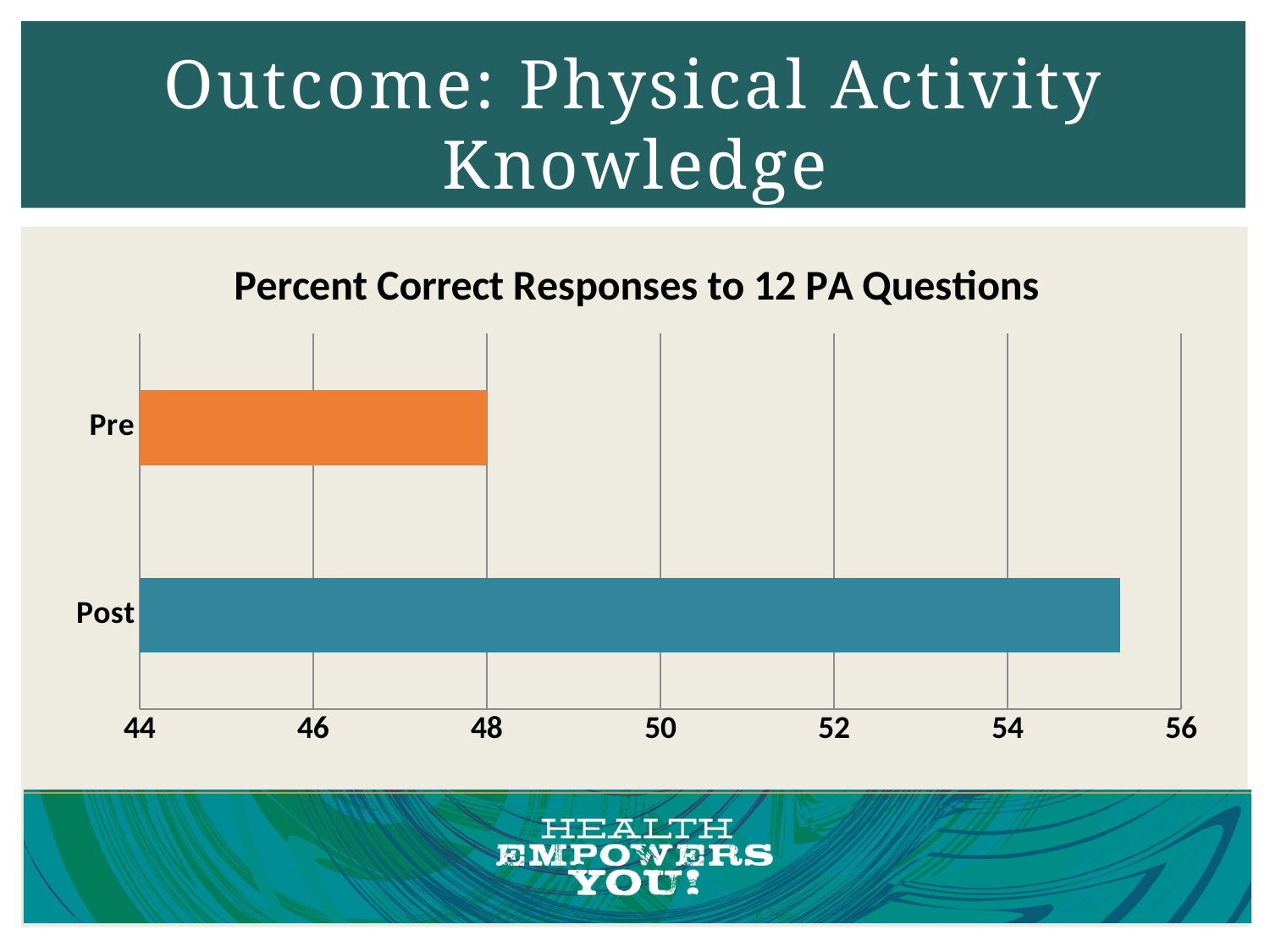
Is the value for Pre greater or less than 46? greater What colour is the bar for Post? blue Which category has the lowest value? Pre What is the lowest value shown on the x axis? 44 What is the value for Pre? 48 What is the title of the chart? Percent Correct Responses to 12 PA Questions How many categories are plotted in the chart? 2 Which category has the highest value? Post Which is larger, the value for Pre or the value for Post? Post Is the value for Post greater or less than 54? greater What kind of chart is shown on the slide? bar chart Is the value for Post greater or less than 56? less